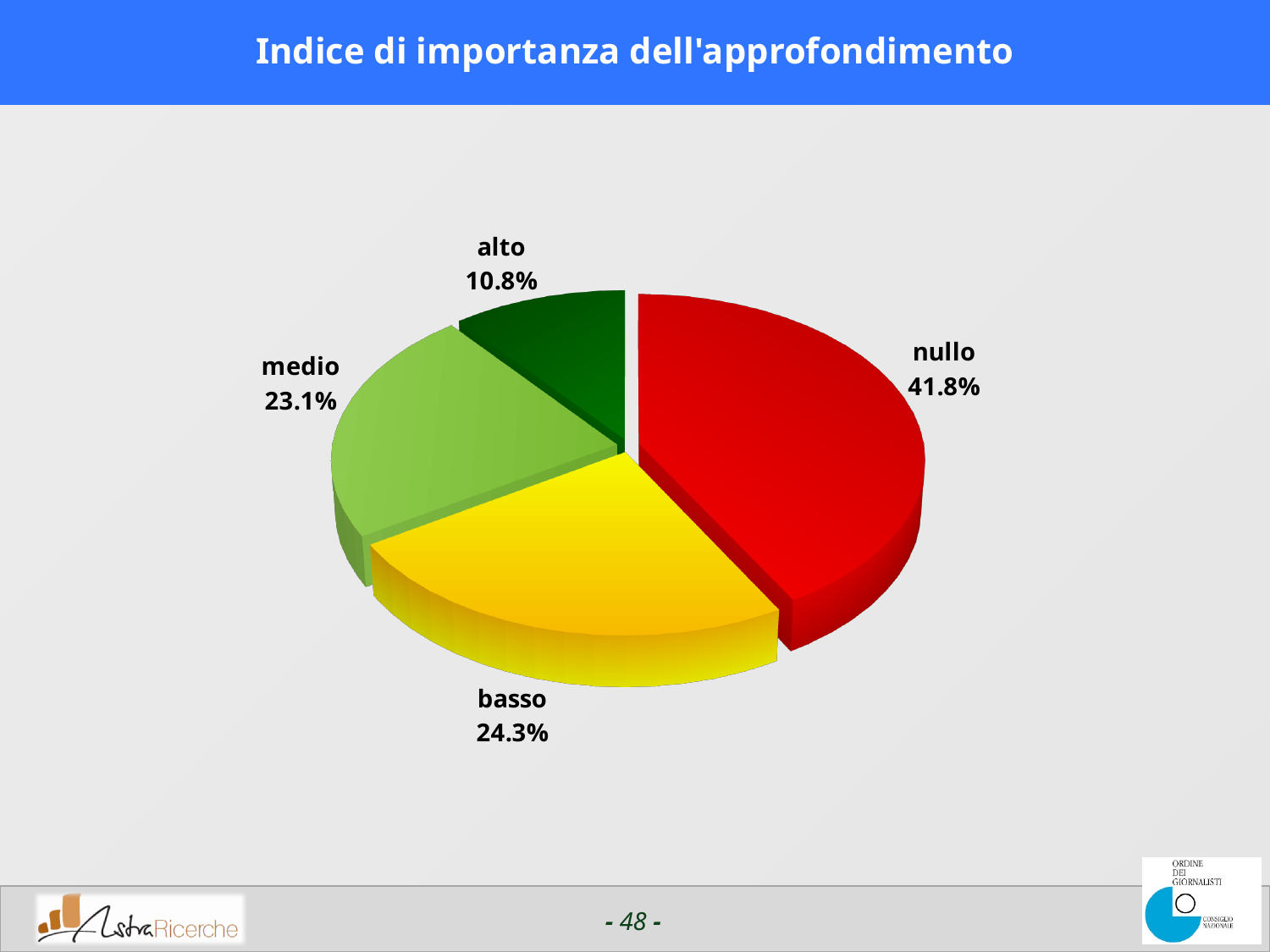
What is the difference in percentage points between "nullo" and "alto"? 31.0 How many slices does the pie chart have? 4 What percentage is shown for the "alto" slice? 10.8% What type of chart is shown on the slide? pie chart Which category has the largest share of the pie? nullo Which is larger, the share for "nullo" or the share for "basso"? nullo What percentage is shown for the "nullo" slice? 41.8% What percentage is shown for the "medio" slice? 23.1% What is the title of the chart? Indice di importanza dell'approfondimento Which category has the smallest share of the pie? alto What percentage is shown for the "basso" slice? 24.3% What is the difference in percentage points between "basso" and "medio"? 1.2